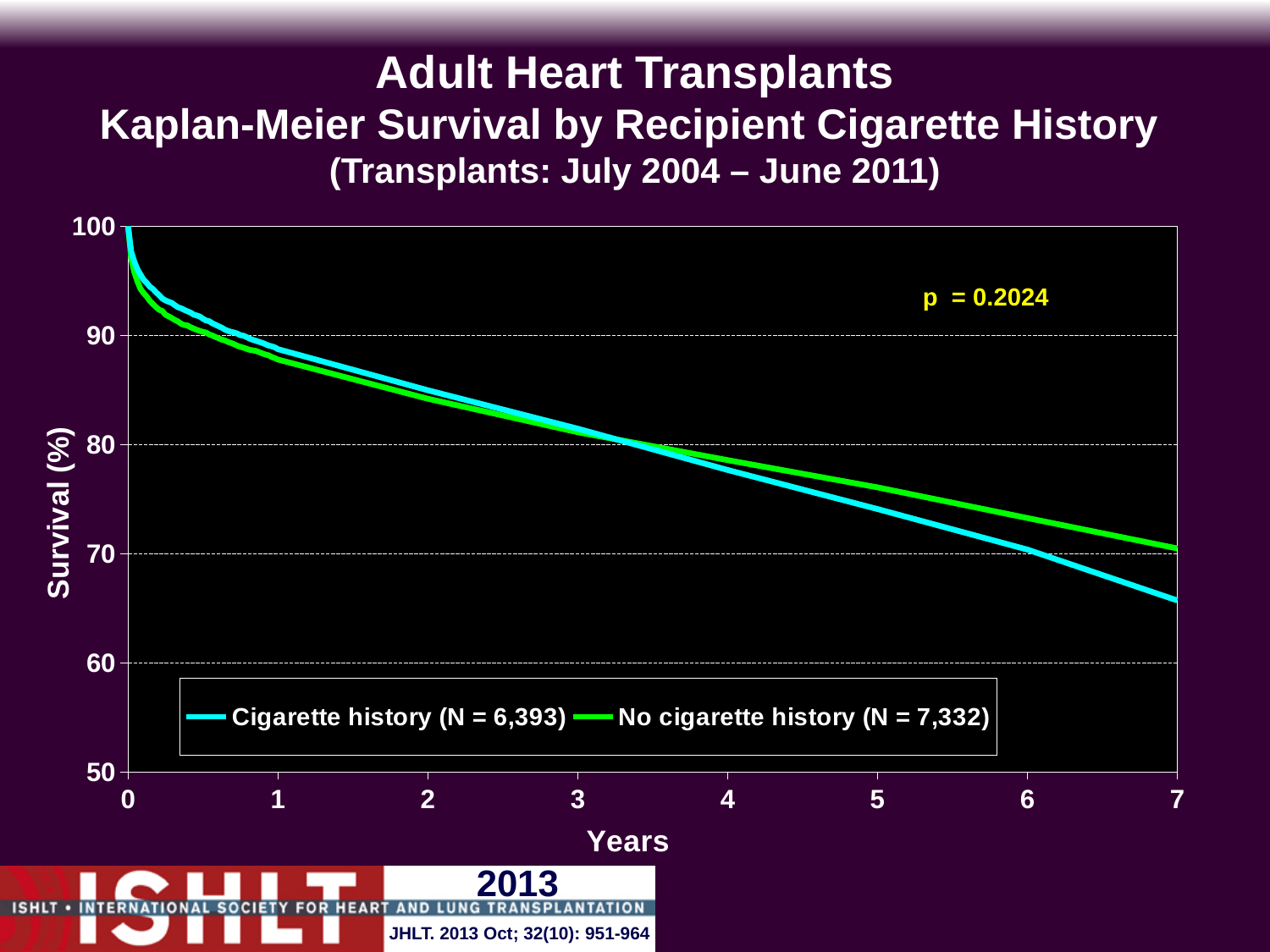
At 7 years, which group has the higher survival: Cigarette history or No cigarette history? No cigarette history Is the survival value for the No cigarette history group at 1 year greater or less than 90? less What colour is the line for the No cigarette history group? green Is the survival value for the Cigarette history group at 7 years greater or less than 70? less What is the label of the y-axis? Survival (%) How many series does the legend list? 2 Do the survival curves rise or fall as years increase? fall Is the survival value for the Cigarette history group at 5 years greater or less than 70? greater What is the N for the No cigarette history group shown in the legend? 7,332 What is the N for the Cigarette history group shown in the legend? 6,393 What p-value is printed on the chart? p = 0.2024 What kind of chart is shown on the slide? line chart